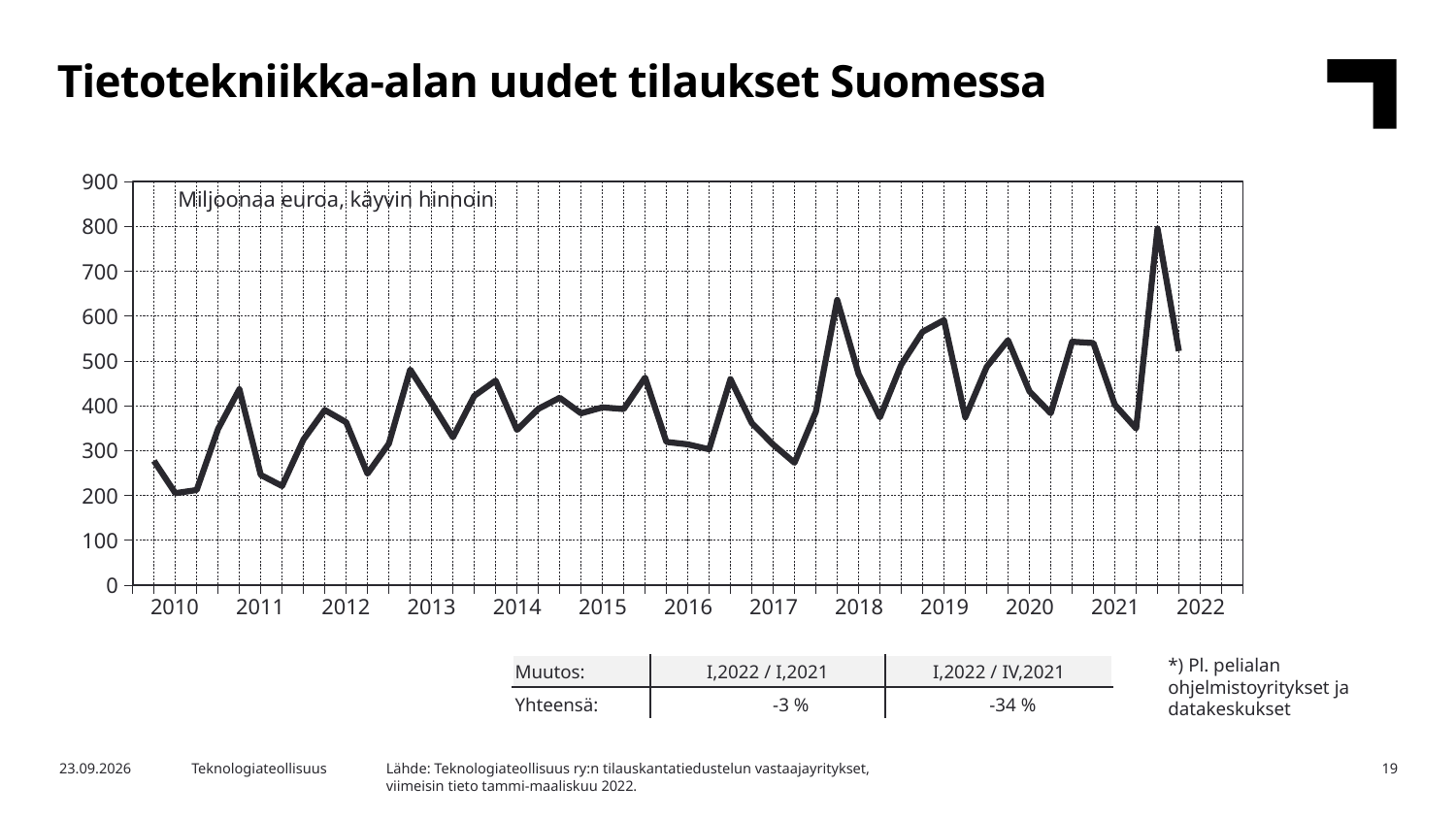
How many years are labelled on the x axis of the chart? 13 Is the lowest point of the line, in 2010, greater or less than 300? less According to the table below the chart, what is the change (Muutos) for I,2022 / IV,2021? -34 % What unit label is printed inside the chart area? Miljoonaa euroa, käyvin hinnoin In which year does the line reach its highest point? 2021 Is the peak value in 2018 greater or less than 500? greater Is the highest point of the line, in late 2021, greater or less than 700? greater Does the line rise or fall from its peak in late 2021 to the last point in 2022? fall What kind of chart is shown on the slide? line chart What is the title of the chart on the slide? Tietotekniikka-alan uudet tilaukset Suomessa In which year does the line reach its lowest point? 2010